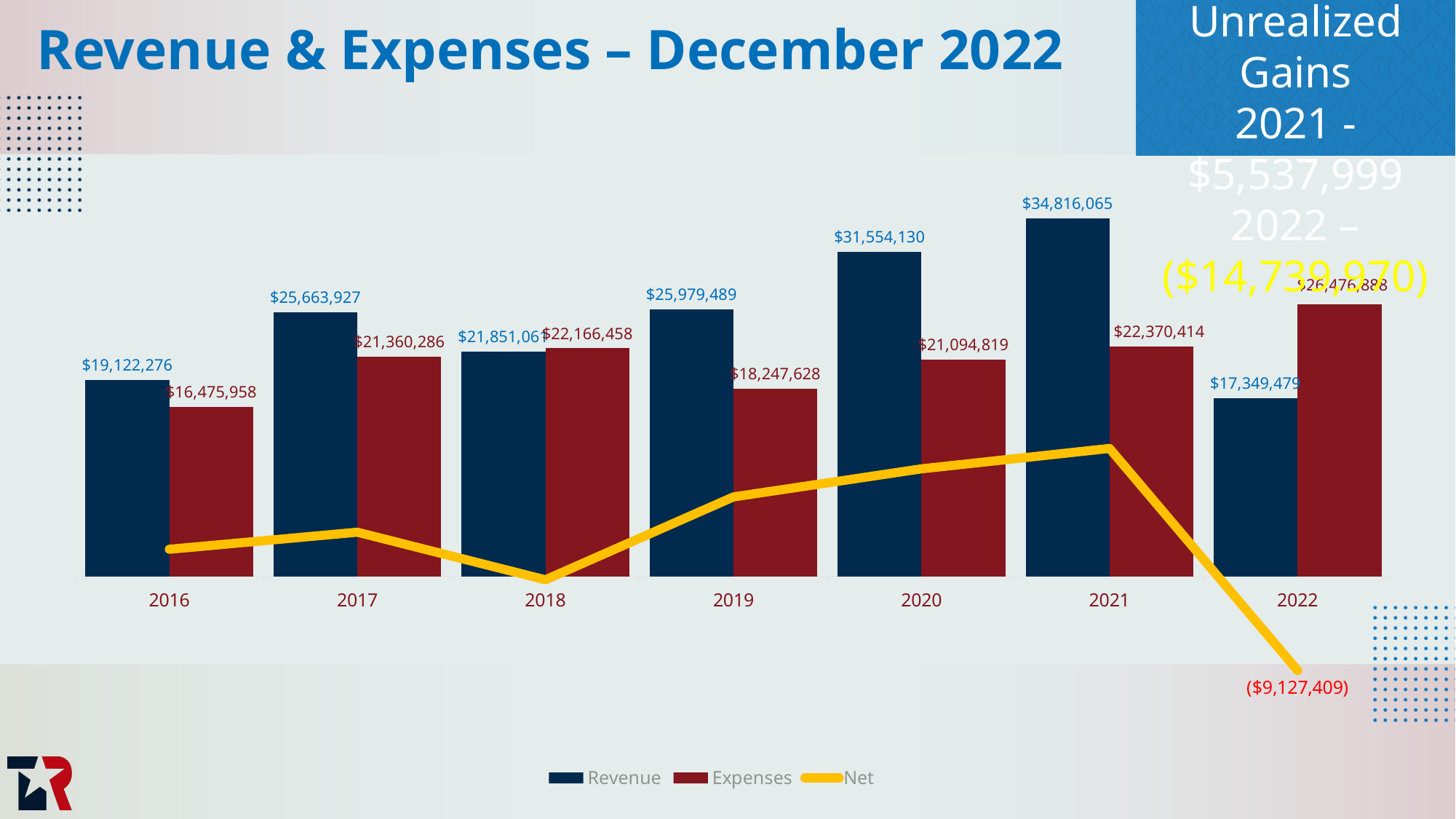
Which year has the highest Revenue? 2021 What is the Revenue value for 2021? $34,816,065 How many series does the legend list? 3 Which year has the lowest Revenue? 2022 Which year has the lowest Expenses? 2016 What is the Net value shown for 2022? ($9,127,409) In 2017, which is larger, Revenue or Expenses? Revenue Does Revenue rise or fall from 2019 to 2021? rise What is the Expenses value for 2019? $18,247,628 In 2016, how much greater is Revenue than Expenses? $2,646,318 What is the difference between Revenue in 2021 and Revenue in 2020? $3,261,935 How many years are shown on the x axis? 7